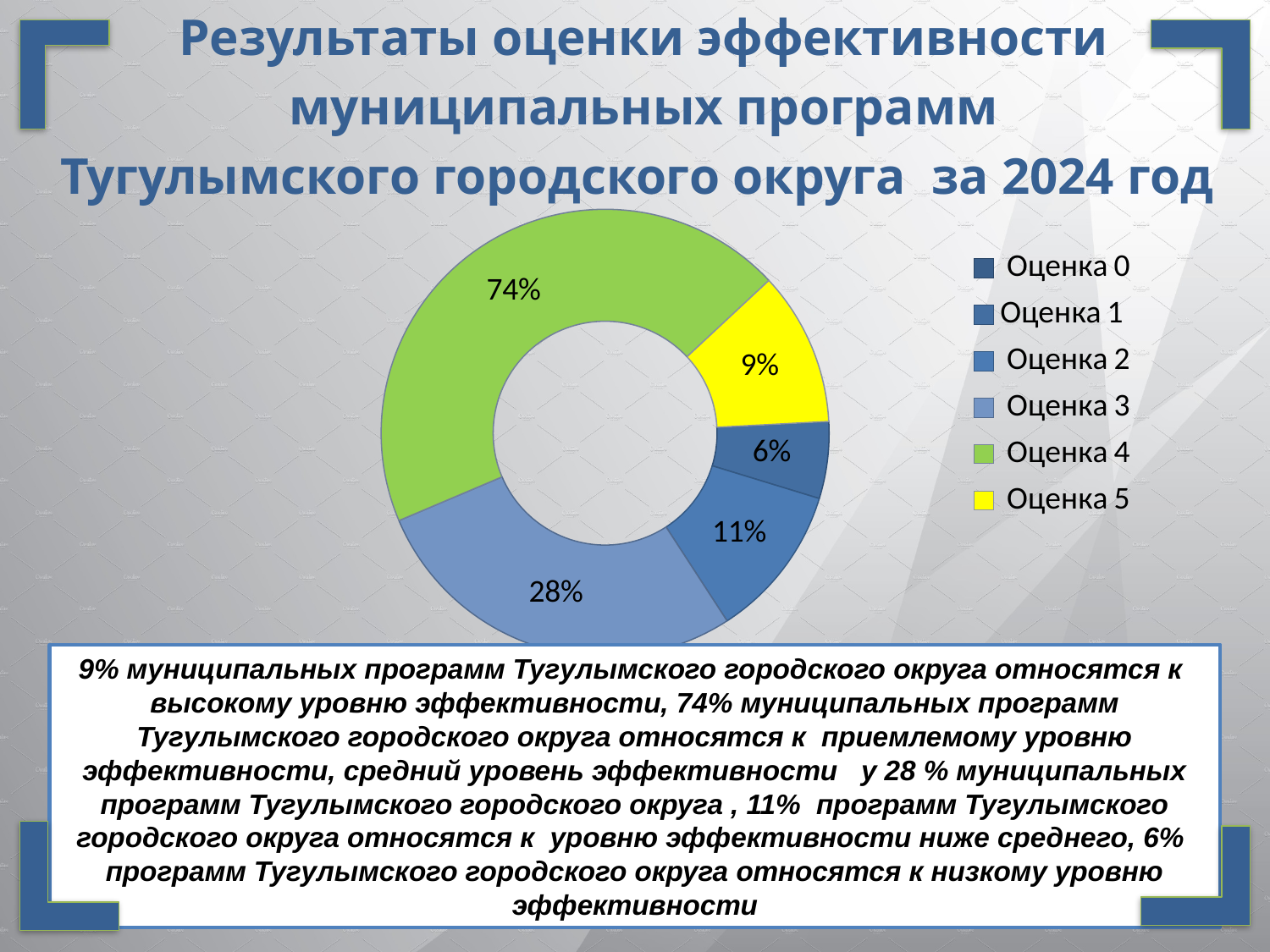
What percentage is shown for Оценка 5? 9% How many entries does the legend list? 6 How many slices with data labels are shown in the chart? 5 What type of chart is shown on the slide? Doughnut (pie) chart What is the smallest percentage labelled on the chart? 6% Which is larger, the slice for Оценка 2 or the slice for Оценка 5? Оценка 2 What percentage is shown for Оценка 4? 74% What percentage is shown for Оценка 2? 11% What colour represents Оценка 5 in the chart? Yellow Which category has the largest slice of the chart? Оценка 4 What is the difference in percentage points between Оценка 4 and Оценка 3? 46 What percentage is shown for Оценка 3? 28%